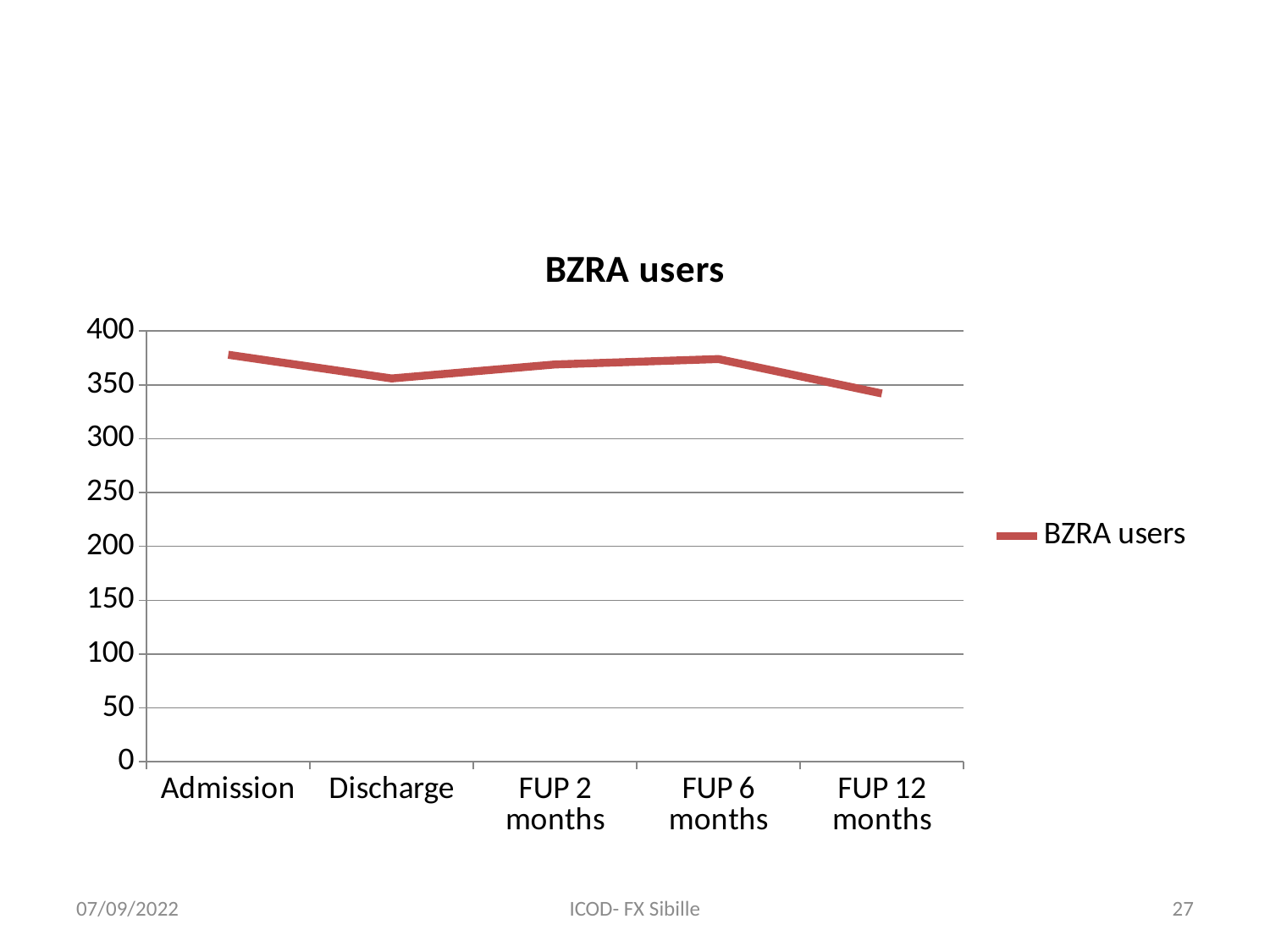
Is the value at FUP 6 months greater or less than 400? less Is the value at Admission greater or less than 350? greater Is the value at Discharge greater or less than 300? greater At which time point is the number of BZRA users lowest? FUP 12 months Which is larger, the value at Admission or the value at FUP 12 months? Admission Overall, does the number of BZRA users rise or fall from Admission to FUP 12 months? fall What is the title of the chart? BZRA users What kind of chart is shown on the slide? line chart What series name appears in the legend? BZRA users How many time points are plotted along the x axis? 5 How many series does the legend list? 1